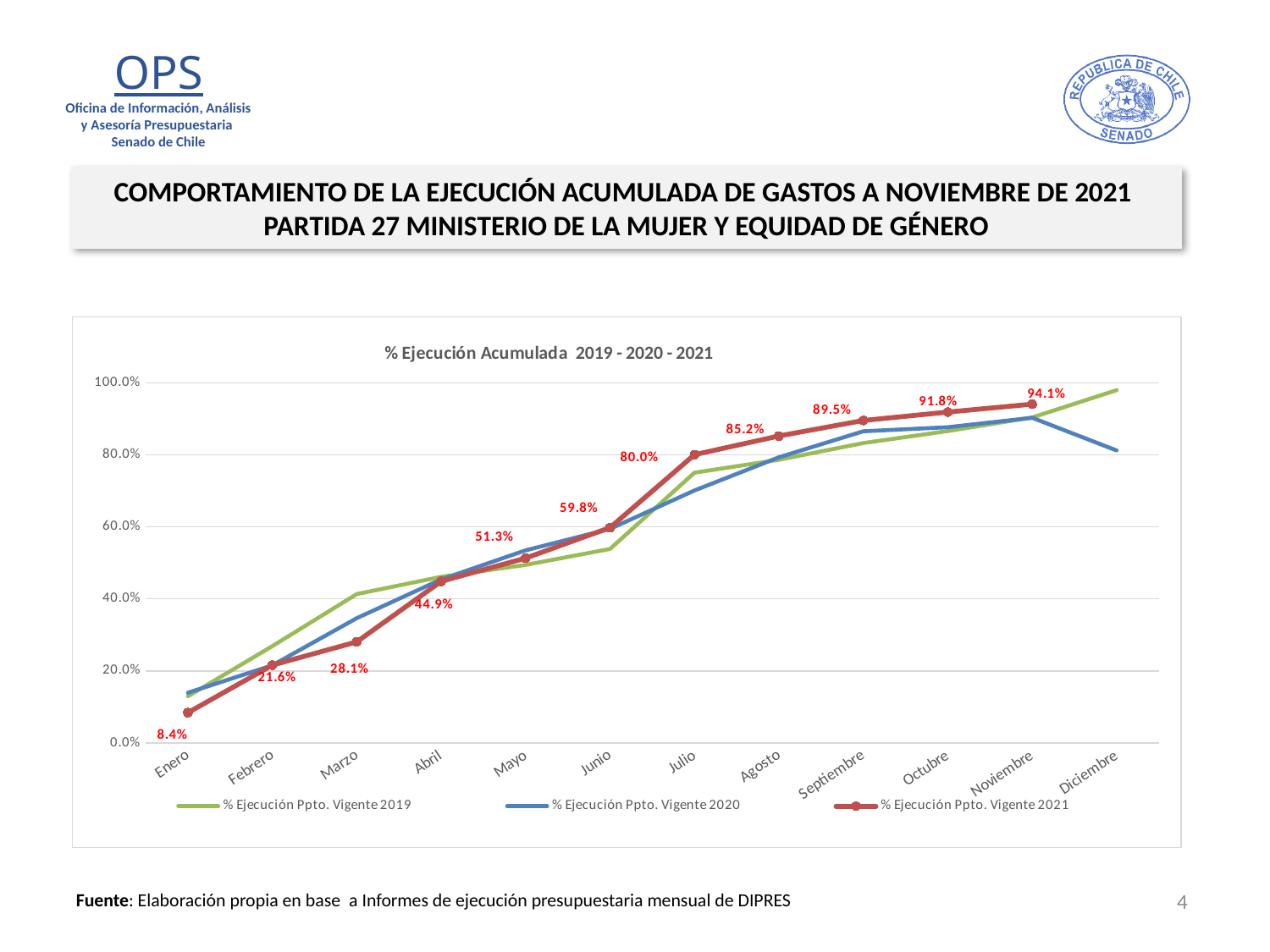
How many months are shown on the x axis? 12 What is the value of % Ejecución Ppto. Vigente 2021 for Julio? 80.0% Does the % Ejecución Ppto. Vigente 2021 series rise or fall from Enero to Noviembre? rise What is the value of % Ejecución Ppto. Vigente 2021 for Enero? 8.4% What kind of chart is shown on the slide? line chart What is the value of % Ejecución Ppto. Vigente 2021 for Noviembre? 94.1% Is the value of % Ejecución Ppto. Vigente 2020 for Diciembre greater or less than 100.0%? less What is the title of the chart? % Ejecución Acumulada 2019 - 2020 - 2021 Which month has the lowest value for % Ejecución Ppto. Vigente 2021? Enero How many series does the legend list? 3 What is the difference between the % Ejecución Ppto. Vigente 2021 values for Noviembre and Octubre? 2.3% Which month has the highest value for % Ejecución Ppto. Vigente 2021? Noviembre